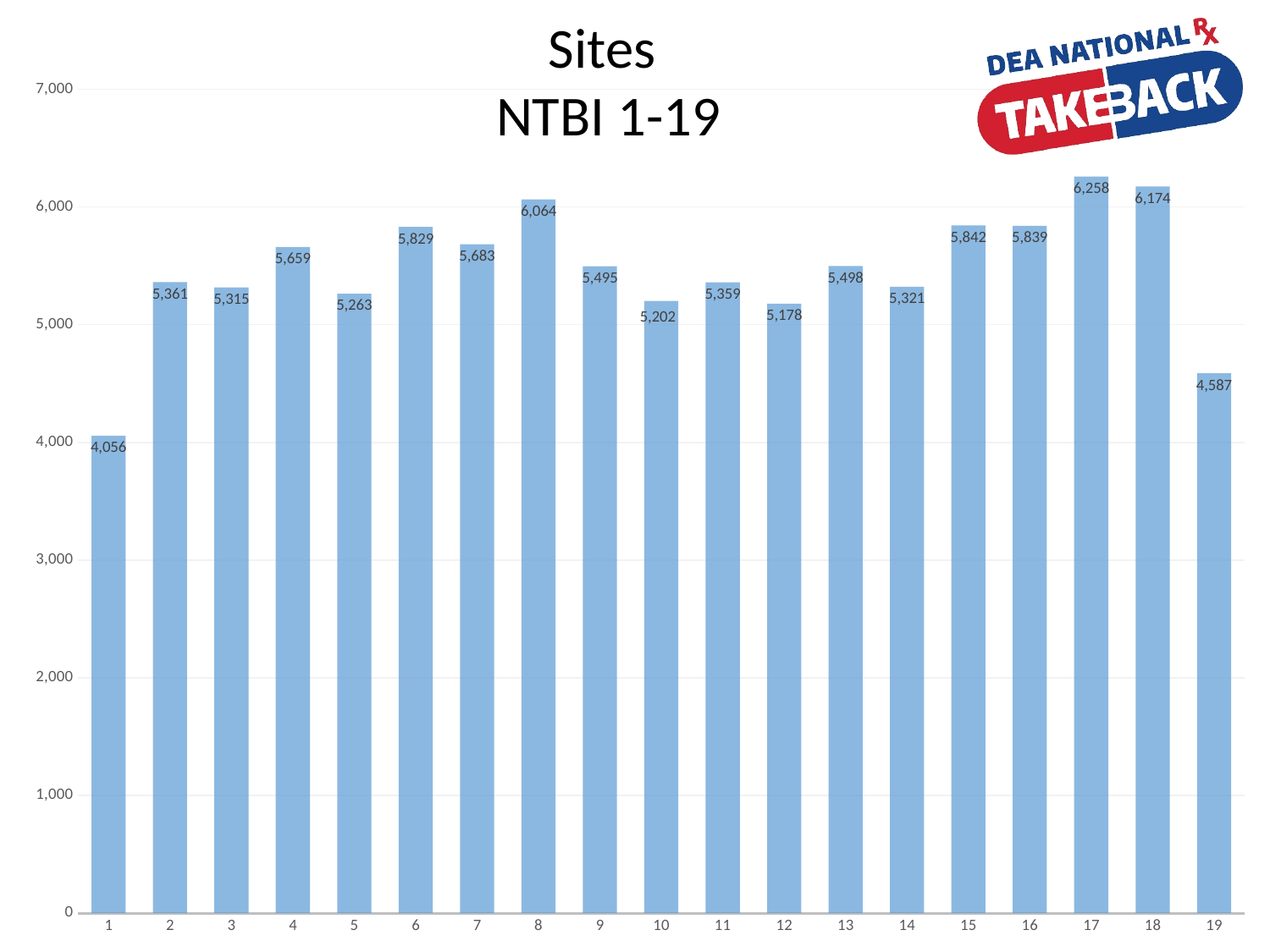
What is the value for NTBI 8? 6,064 What is the title of the chart? Sites NTBI 1-19 What is the value for NTBI 12? 5,178 Which NTBI has the lowest number of sites? 1 Which is larger, the value for NTBI 6 or the value for NTBI 7? NTBI 6 What is the difference between the values for NTBI 19 and NTBI 1? 531 What kind of chart is shown on the slide? bar chart What is the value for NTBI 19? 4,587 What is the difference between the values for NTBI 17 and NTBI 18? 84 How many NTBI categories are shown on the chart? 19 Is the value for NTBI 10 greater or less than 5,000? greater Which NTBI has the highest number of sites? 17